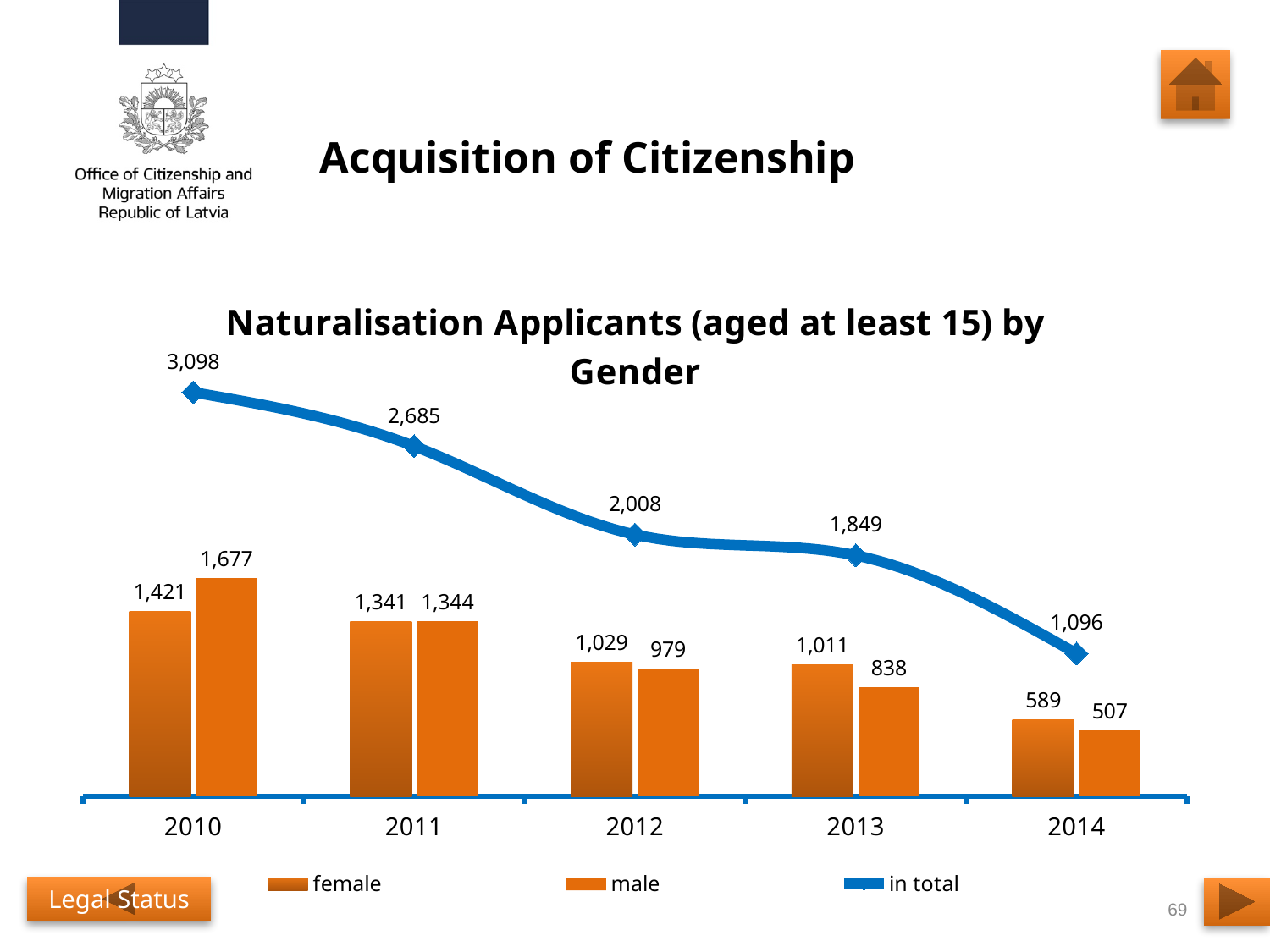
What is the title of the chart? Naturalisation Applicants (aged at least 15) by Gender What is the value for female applicants in 2010? 1,421 What is the value for male applicants in 2013? 838 What is the difference between the female and male values in 2010? 256 In 2013, which is larger, the female value or the male value? female Which year has the lowest value for male applicants? 2014 What is the 'in total' value for 2012? 2,008 Which year has the highest 'in total' value? 2010 What kind of chart is this? Combined bar and line chart Does the 'in total' line rise or fall from 2010 to 2014? fall How many series does the legend list? 3 How many years are shown on the x axis? 5